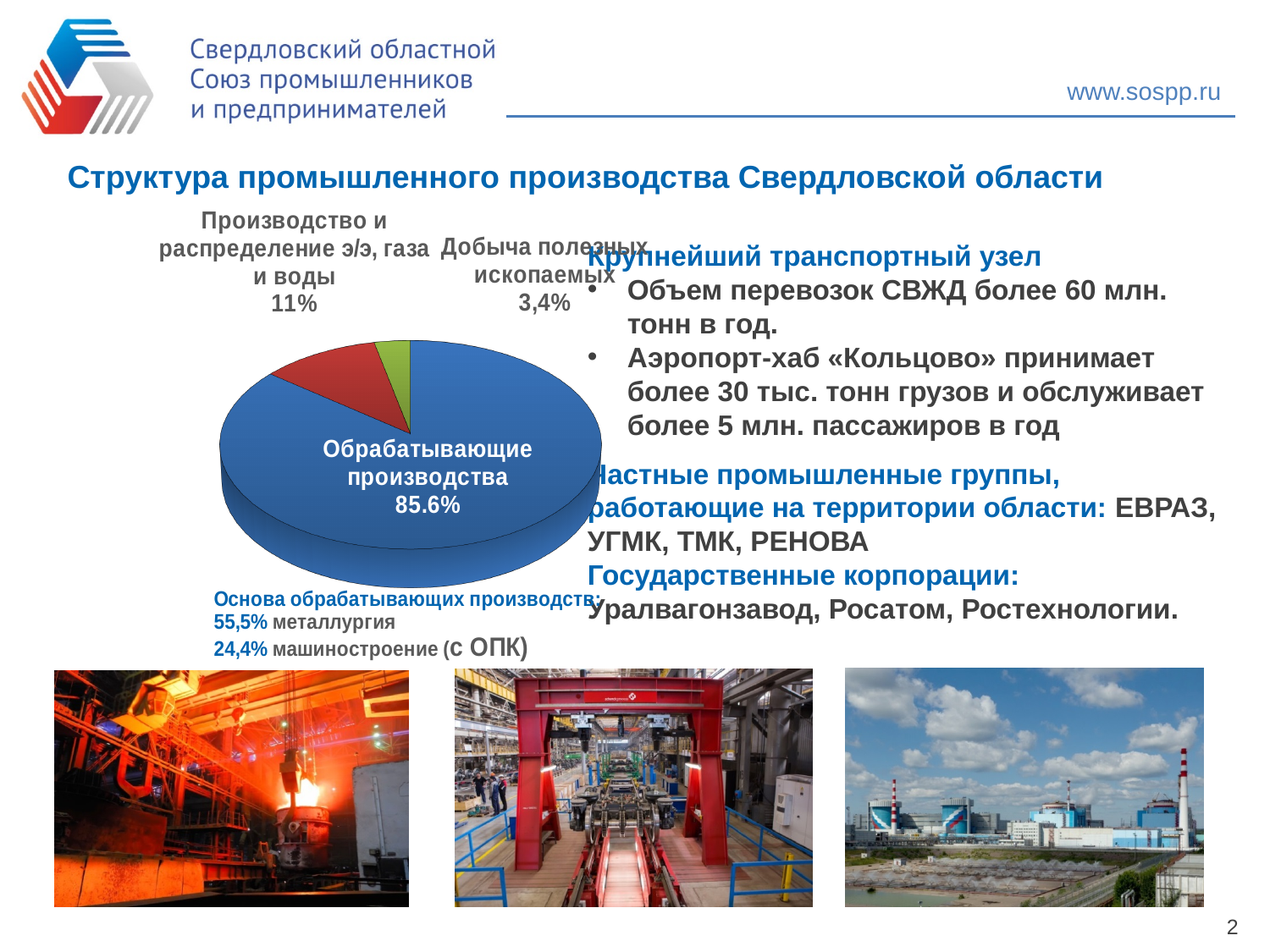
Which slice of the pie chart is the largest? Обрабатывающие производства What is the value shown for Производство и распределение э/э, газа и воды? 11% Which is larger: Производство и распределение э/э, газа и воды or Добыча полезных ископаемых? Производство и распределение э/э, газа и воды What colour is the Добыча полезных ископаемых slice in the pie chart? green What share of the pie does Обрабатывающие производства hold? 85.6% What is the value shown for Добыча полезных ископаемых? 3,4% What kind of chart is shown on the slide? pie chart What colour is the Обрабатывающие производства slice in the pie chart? blue What is the difference between the shares of Обрабатывающие производства and Производство и распределение э/э, газа и воды? 74.6% Which slice of the pie chart is the smallest? Добыча полезных ископаемых What is the difference between the shares of Производство и распределение э/э, газа и воды and Добыча полезных ископаемых? 7,6% How many slices does the pie chart have? 3